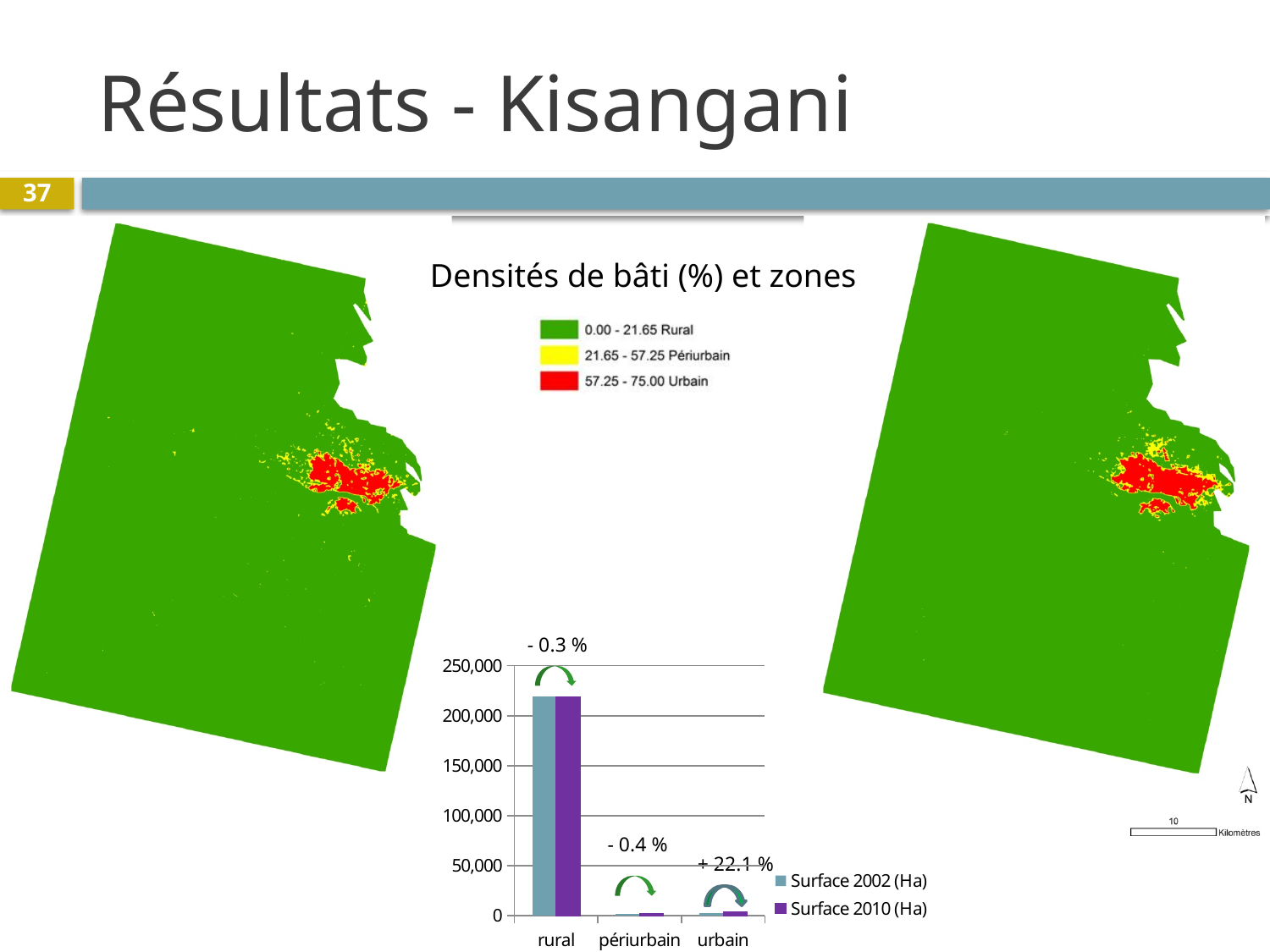
Which category has the highest values in the bar chart? rural What percentage change is annotated above the urbain bars in the bar chart? + 22.1 % What percentage change is annotated above the rural bars in the bar chart? - 0.3 % What are the two series names listed in the legend of the bar chart? Surface 2002 (Ha) and Surface 2010 (Ha) Is the value for urbain Surface 2002 (Ha) greater or less than 50,000? less How many categories are shown on the x axis of the bar chart? 3 Is the value for périurbain Surface 2010 (Ha) greater or less than 50,000? less Which is larger in the bar chart: rural Surface 2002 (Ha) or urbain Surface 2002 (Ha)? rural Surface 2002 (Ha) Is the value for rural Surface 2002 (Ha) greater or less than 200,000? greater How many series does the legend of the bar chart list? 2 What kind of chart is shown at the bottom of the slide? bar chart